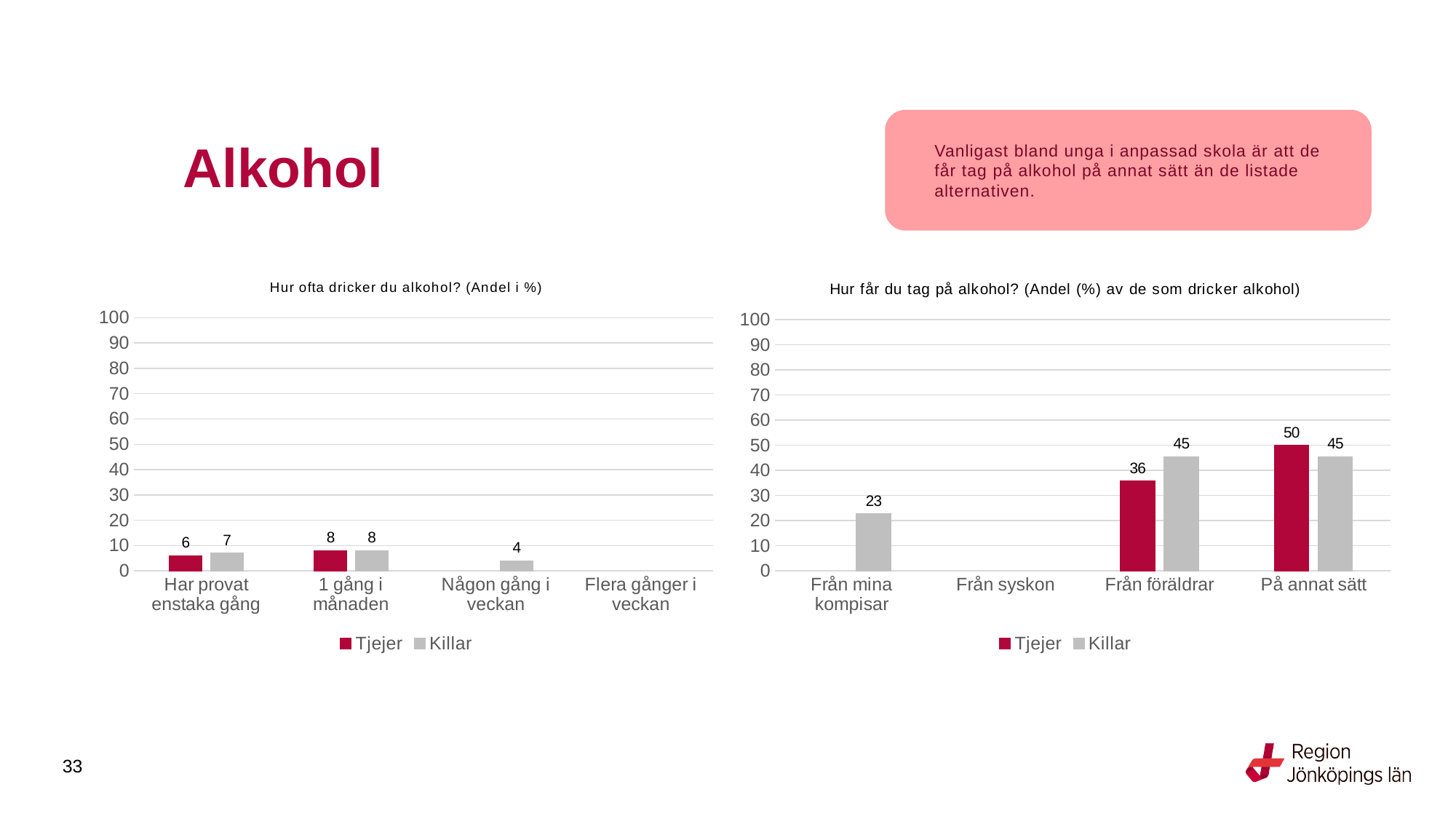
In the chart titled "Hur får du tag på alkohol? (Andel (%) av de som dricker alkohol)", what is the difference between the Killar and Tjejer values for "Från föräldrar"? 9 What kind of chart is the chart titled "Hur får du tag på alkohol? (Andel (%) av de som dricker alkohol)"? Bar chart In the chart titled "Hur får du tag på alkohol? (Andel (%) av de som dricker alkohol)", which is larger for "På annat sätt": Tjejer or Killar? Tjejer In the chart titled "Hur ofta dricker du alkohol? (Andel i %)", how many categories are shown on the x axis? 4 In the chart titled "Hur ofta dricker du alkohol? (Andel i %)", what is the value for Tjejer in the category "Har provat enstaka gång"? 6 In the chart titled "Hur ofta dricker du alkohol? (Andel i %)", what are the two legend entries? Tjejer and Killar In the chart titled "Hur får du tag på alkohol? (Andel (%) av de som dricker alkohol)", how many series does the legend list? 2 In the chart titled "Hur får du tag på alkohol? (Andel (%) av de som dricker alkohol)", what is the value for Tjejer in the category "Från föräldrar"? 36 In the chart titled "Hur ofta dricker du alkohol? (Andel i %)", what is the value for Killar in the category "Någon gång i veckan"? 4 In the chart titled "Hur får du tag på alkohol? (Andel (%) av de som dricker alkohol)", what is the value for Killar in the category "Från mina kompisar"? 23 In the chart titled "Hur får du tag på alkohol? (Andel (%) av de som dricker alkohol)", which category has the highest value for Tjejer? På annat sätt In the chart titled "Hur ofta dricker du alkohol? (Andel i %)", what is the difference between the Killar and Tjejer values for "Har provat enstaka gång"? 1